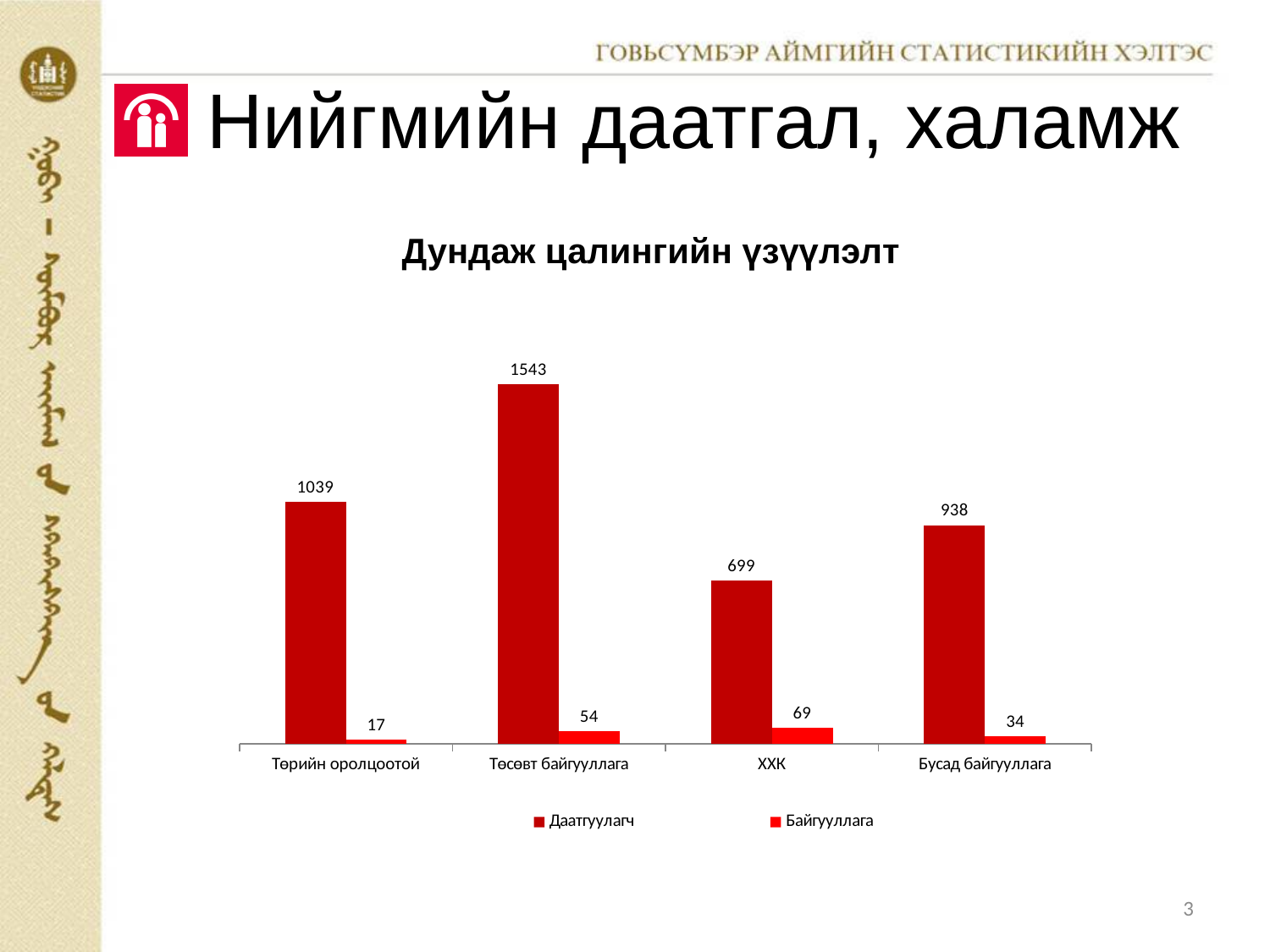
How many categories are shown on the x axis? 4 What kind of chart is shown on the slide? Bar chart What is the value for Байгууллага in the ХХК category? 69 How many series does the legend list? 2 Which category has the highest Даатгуулагч value? Төсөвт байгууллага What is the value for Байгууллага in the Төрийн оролцоотой category? 17 Which is larger: the Даатгуулагч value for Төрийн оролцоотой or for Бусад байгууллага? Төрийн оролцоотой What is the value for Даатгуулагч in the Бусад байгууллага category? 938 What is the difference between the Даатгуулагч values for Төсөвт байгууллага and Төрийн оролцоотой? 504 What is the title of the chart? Дундаж цалингийн үзүүлэлт What is the value for Даатгуулагч in the Төсөвт байгууллага category? 1543 Which category has the lowest Байгууллага value? Төрийн оролцоотой